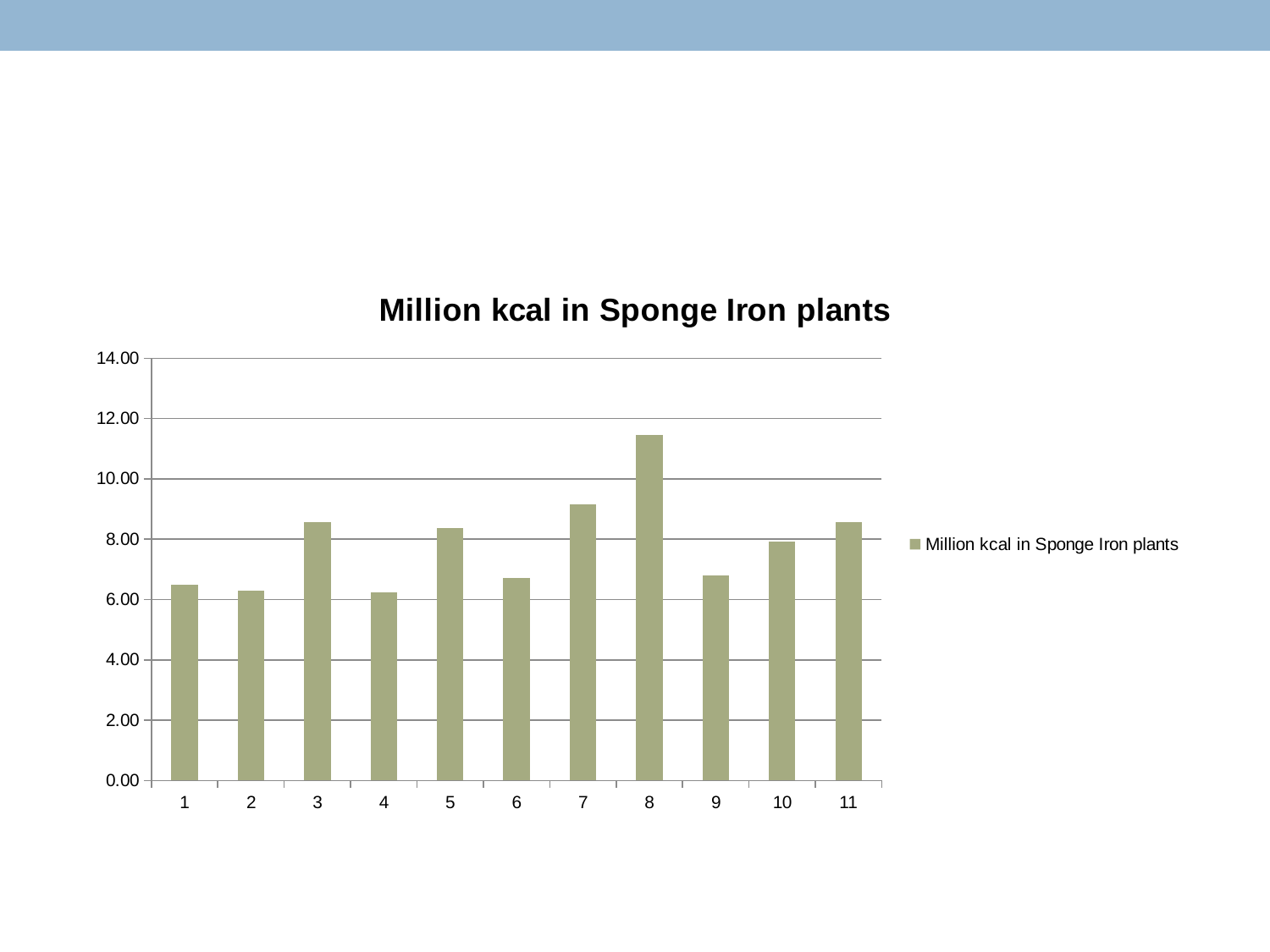
What is the title of the chart? Million kcal in Sponge Iron plants Which is larger, the value for category 10 or category 6? 10 How many categories are plotted on the x axis? 11 Is the value for category 4 greater or less than 8.00? less Which is larger, the value for category 7 or category 5? 7 How many series does the legend list? 1 What type of chart is shown on the slide? Bar chart Is the value for category 8 greater or less than 10.00? greater Is the value for category 1 greater or less than 6.00? greater Which category has the highest value? 8